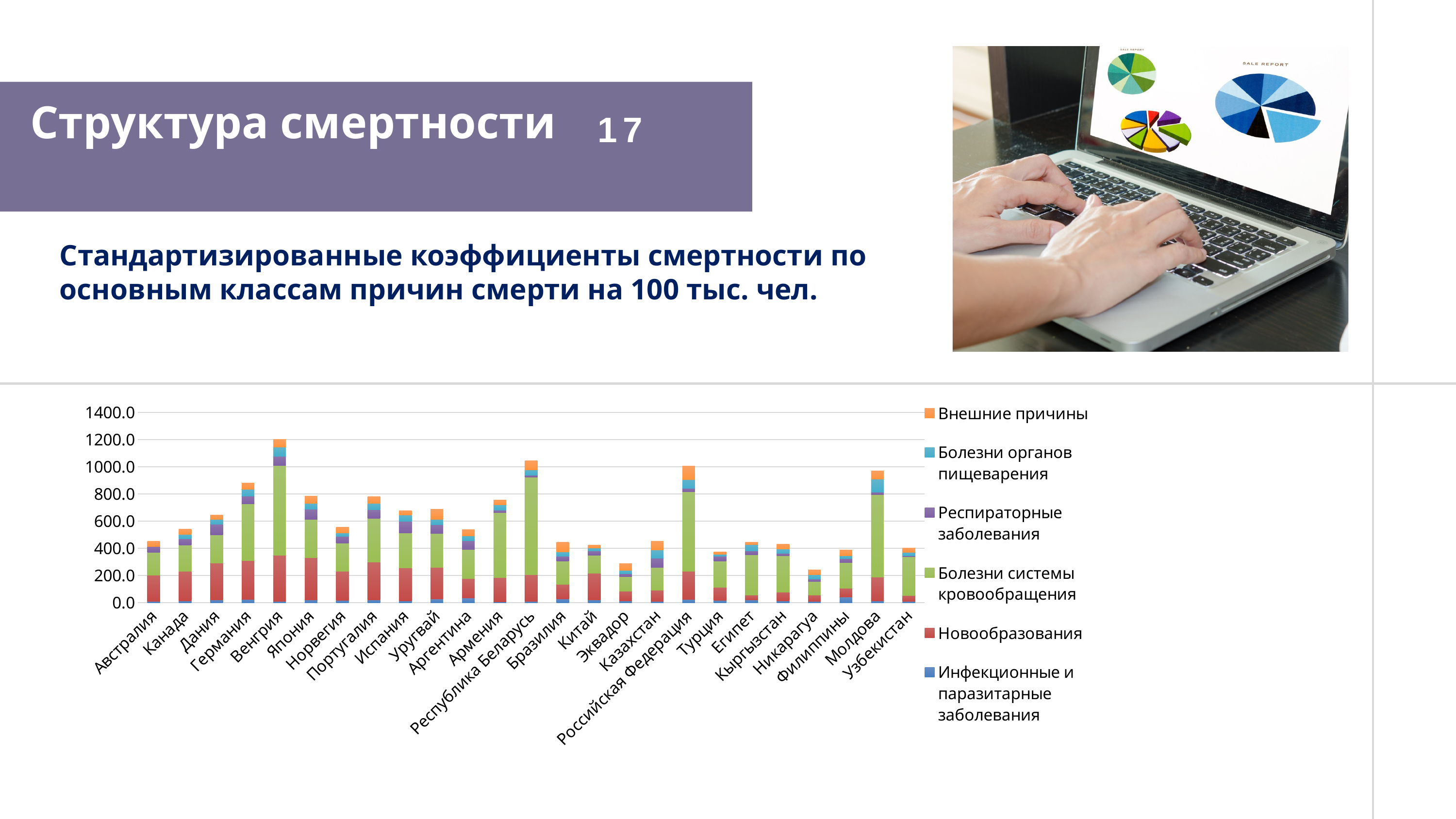
Which country has the lowest total bar in the chart? Никарагуа How many countries are shown on the x axis of the chart? 25 Is the total value for Никарагуа greater or less than 400? less Which country has the highest total bar in the chart? Венгрия How many series does the chart legend list? 6 Is the total value for Республика Беларусь greater or less than 800? greater Which has a larger total bar, Венгрия or Канада? Венгрия Is the total value for Эквадор greater or less than 400? less What kind of chart is shown on the slide? Stacked bar chart Which series is shown in red in the chart legend? Новообразования Which has a larger total bar, Австралия or Никарагуа? Австралия